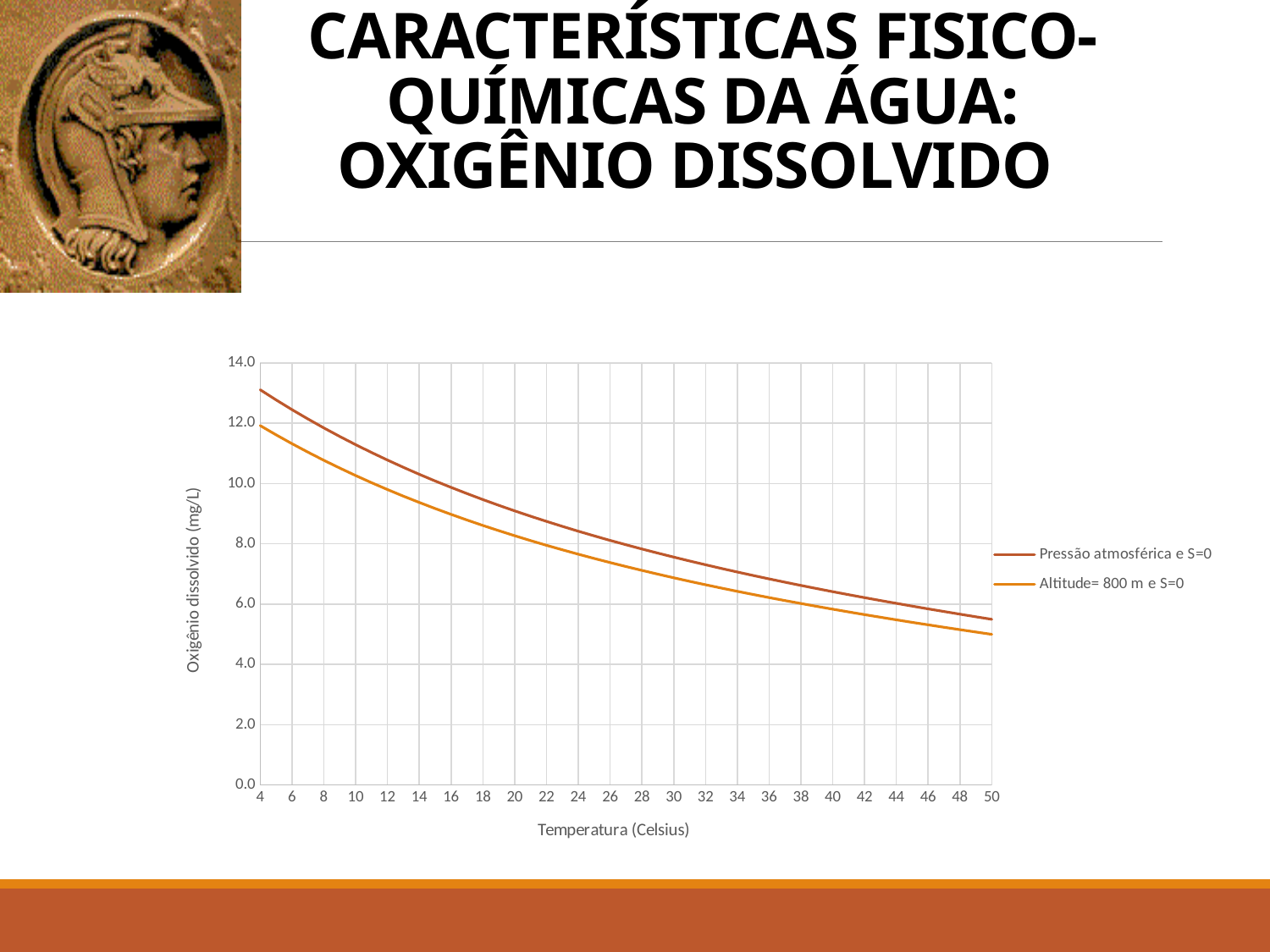
What is the label of the chart's vertical axis? Oxigênio dissolvido (mg/L) Is the value for 'Altitude= 800 m e S=0' at 4 °C greater or less than 10.0? greater Is the value for 'Pressão atmosférica e S=0' at 20 °C greater or less than 8.0? greater Is the value for 'Pressão atmosférica e S=0' at 4 °C greater or less than 12.0? greater As temperature increases along the x axis, do the dissolved oxygen values rise or fall? fall What kind of chart is shown on the slide? line chart At a temperature of 20 °C, which series has the higher dissolved oxygen value? Pressão atmosférica e S=0 How many series does the chart legend list? 2 What is the label of the chart's horizontal axis? Temperatura (Celsius)